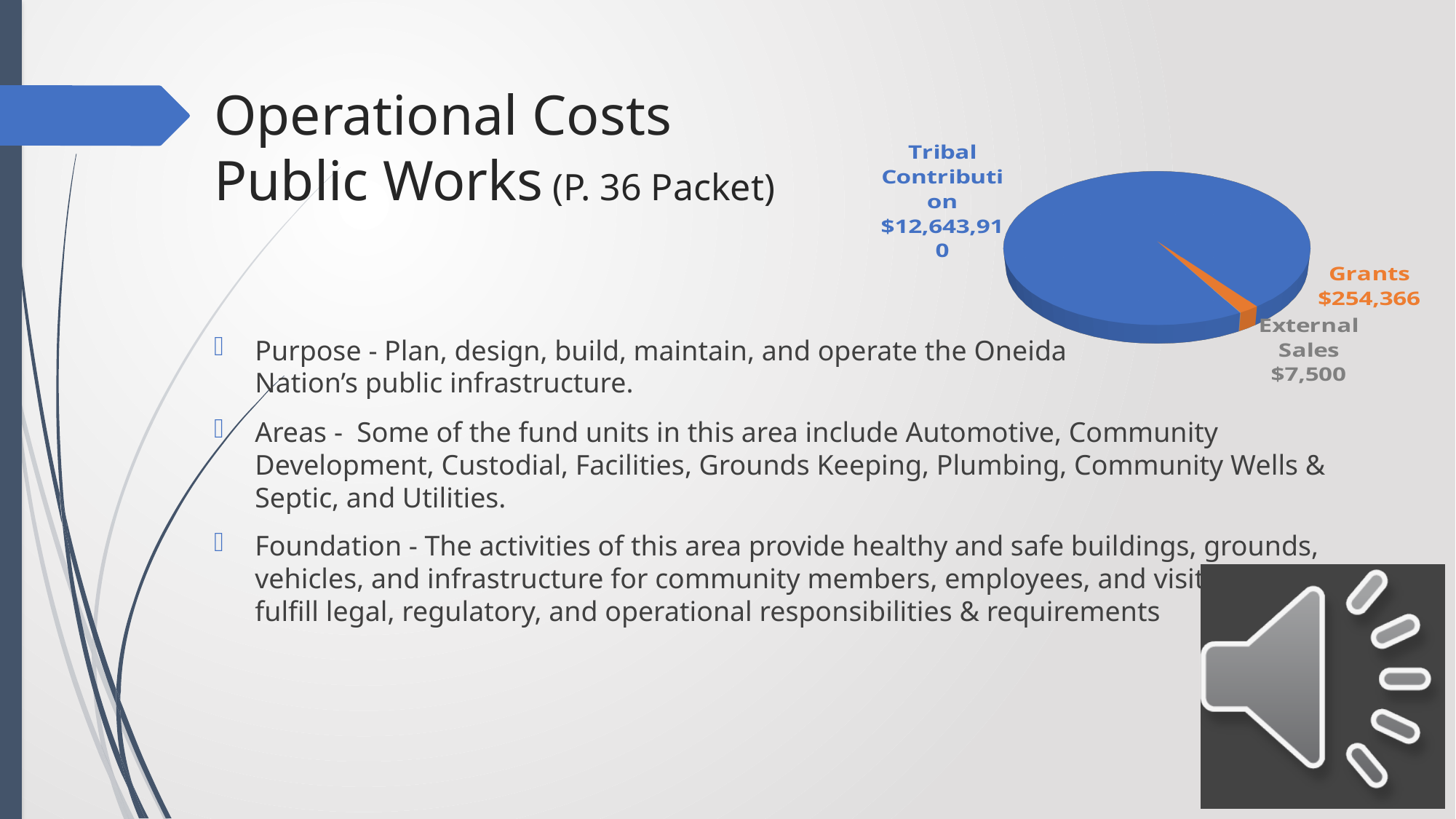
Which is larger in the pie chart, Grants or External Sales? Grants How many slices does the pie chart have? 3 Which category has the smallest slice in the pie chart? External Sales What colour is the Grants slice in the pie chart? orange What is the value shown for Tribal Contribution in the pie chart? $12,643,910 What is the difference between the Grants value and the External Sales value in the pie chart? $246,866 What is the difference between the Tribal Contribution value and the Grants value in the pie chart? $12,389,544 What kind of chart is shown on the slide? pie chart What is the value shown for External Sales in the pie chart? $7,500 What is the value shown for Grants in the pie chart? $254,366 What is the total of all three slices in the pie chart? $12,905,776 Which category has the largest slice in the pie chart? Tribal Contribution